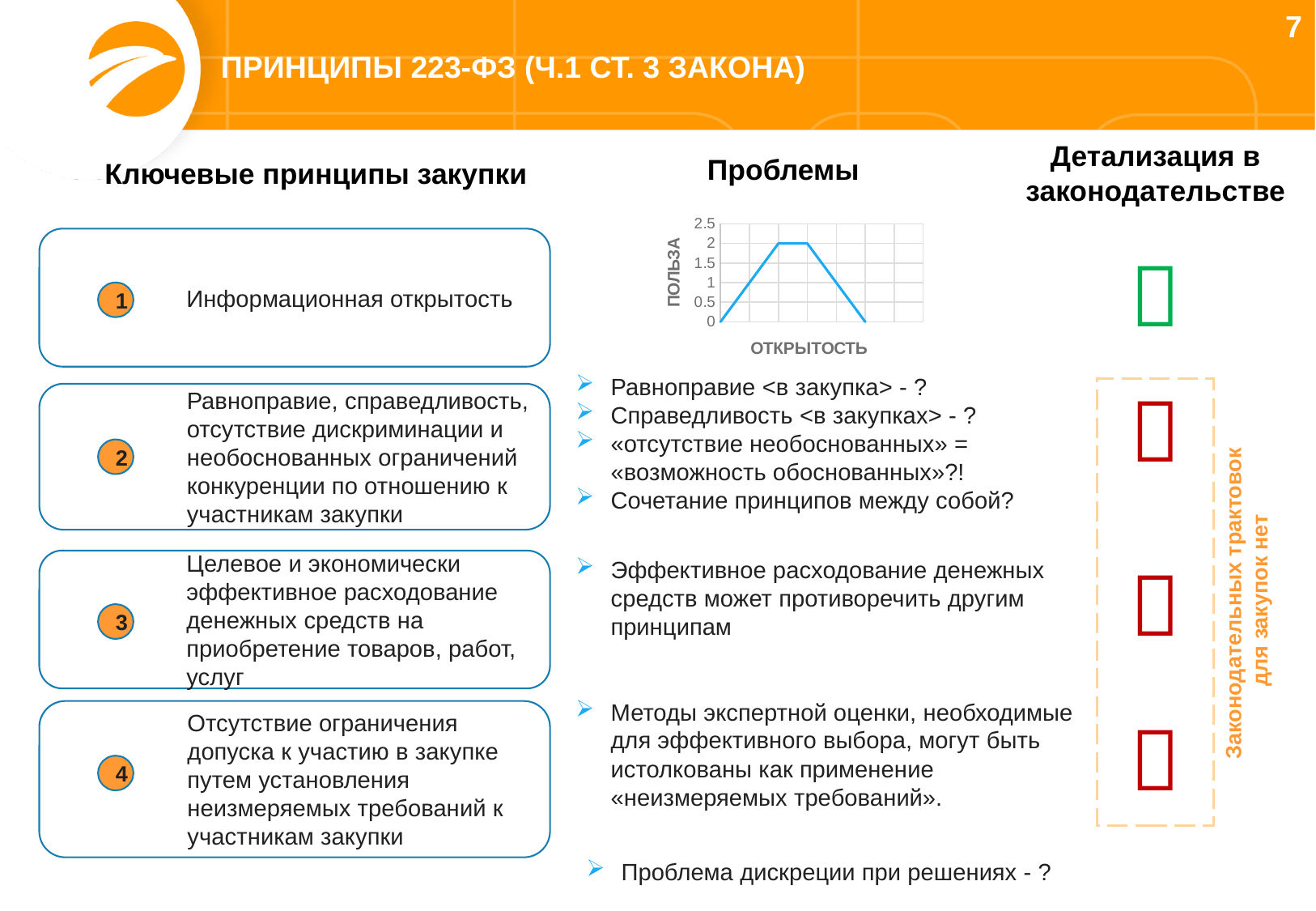
What is the lowest value of the line in the chart? 0 How does the line behave as openness (ОТКРЫТОСТЬ) increases along the x axis? rises, stays flat, then falls At what value does the line start at the left edge of the chart? 0 Is the peak value of the line greater or less than 1.5? greater What is the step between consecutive ticks on the vertical axis? 0.5 What is the label of the vertical axis of the chart? ПОЛЬЗА Is the peak value of the line greater or less than 2.5? less What kind of chart is shown under the heading "Проблемы"? line chart What is the label of the horizontal axis of the chart? ОТКРЫТОСТЬ What is the highest tick value shown on the vertical axis of the chart? 2.5 What is the maximum value reached by the line in the chart? 2